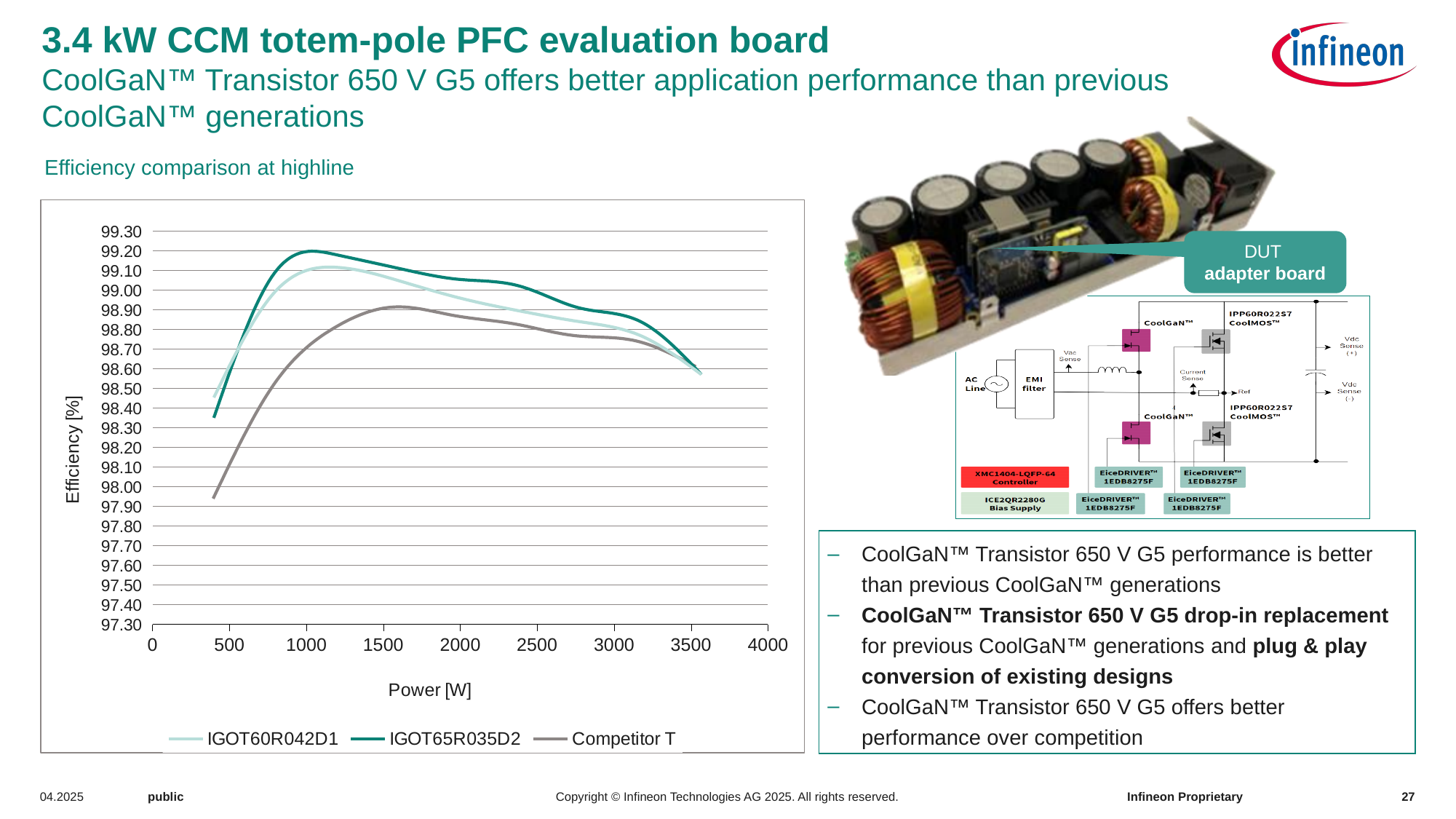
How many series does the legend of the efficiency chart list? 3 Which series is drawn in dark green in the efficiency chart? IGOT65R035D2 What kind of chart is shown under "Efficiency comparison at highline"? Line chart At 2000 W, which series has the higher efficiency: IGOT60R042D1 or Competitor T? IGOT60R042D1 What is the label of the x axis of the efficiency chart? Power [W] Does the efficiency of Competitor T rise or fall as power increases from 2000 W to 3500 W? fall Which series has the lowest efficiency across most of the power range? Competitor T Is the peak efficiency of Competitor T greater or less than 98.80? greater At 1000 W, which series has the higher efficiency: IGOT65R035D2 or Competitor T? IGOT65R035D2 Which series reaches the highest peak efficiency in the chart? IGOT65R035D2 Is the peak efficiency of IGOT65R035D2 greater or less than 99.00? greater Is the efficiency of Competitor T at its lowest power point (around 400 W) greater or less than 98.20? less